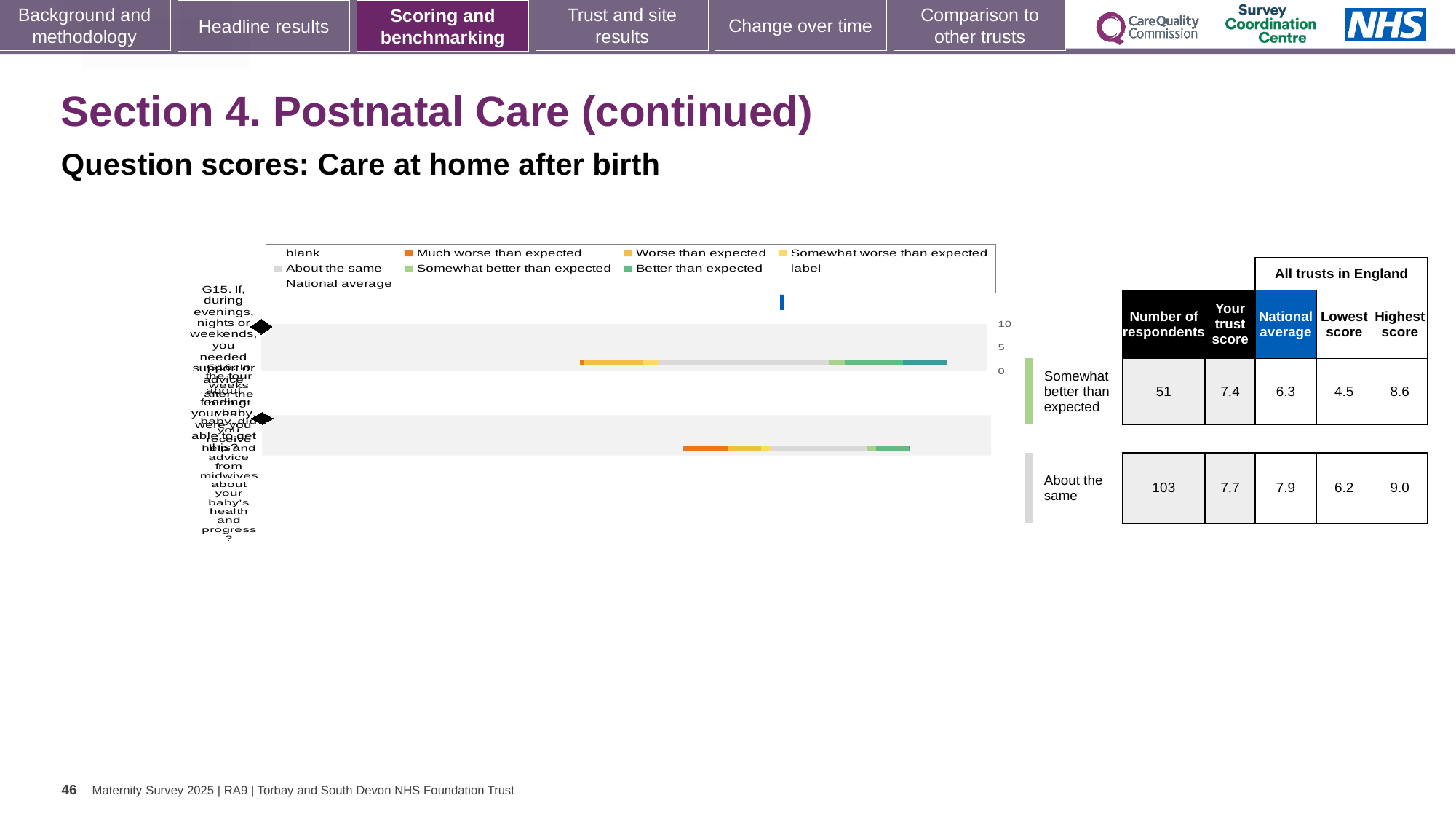
For the top row rated 'Somewhat better than expected', what is the difference between the trust score and the national average? 1.1 What is the difference in number of respondents between the 'About the same' row and the 'Somewhat better than expected' row? 52 How many question rows are plotted in the chart? 2 What is the lowest score across all trusts in England for the row rated 'Somewhat better than expected'? 4.5 What is the number of respondents for the top row, rated 'Somewhat better than expected'? 51 What kind of chart is shown on the slide? bar chart What is the national average for the top row, rated 'Somewhat better than expected'? 6.3 For the top row rated 'Somewhat better than expected', which is larger: the trust score or the national average? the trust score What is the trust score for the bottom row, rated 'About the same'? 7.7 What is the highest score across all trusts in England for the row rated 'About the same'? 9.0 What is the subtitle describing the chart's content? Question scores: Care at home after birth Which row has the higher 'Highest score' value? About the same